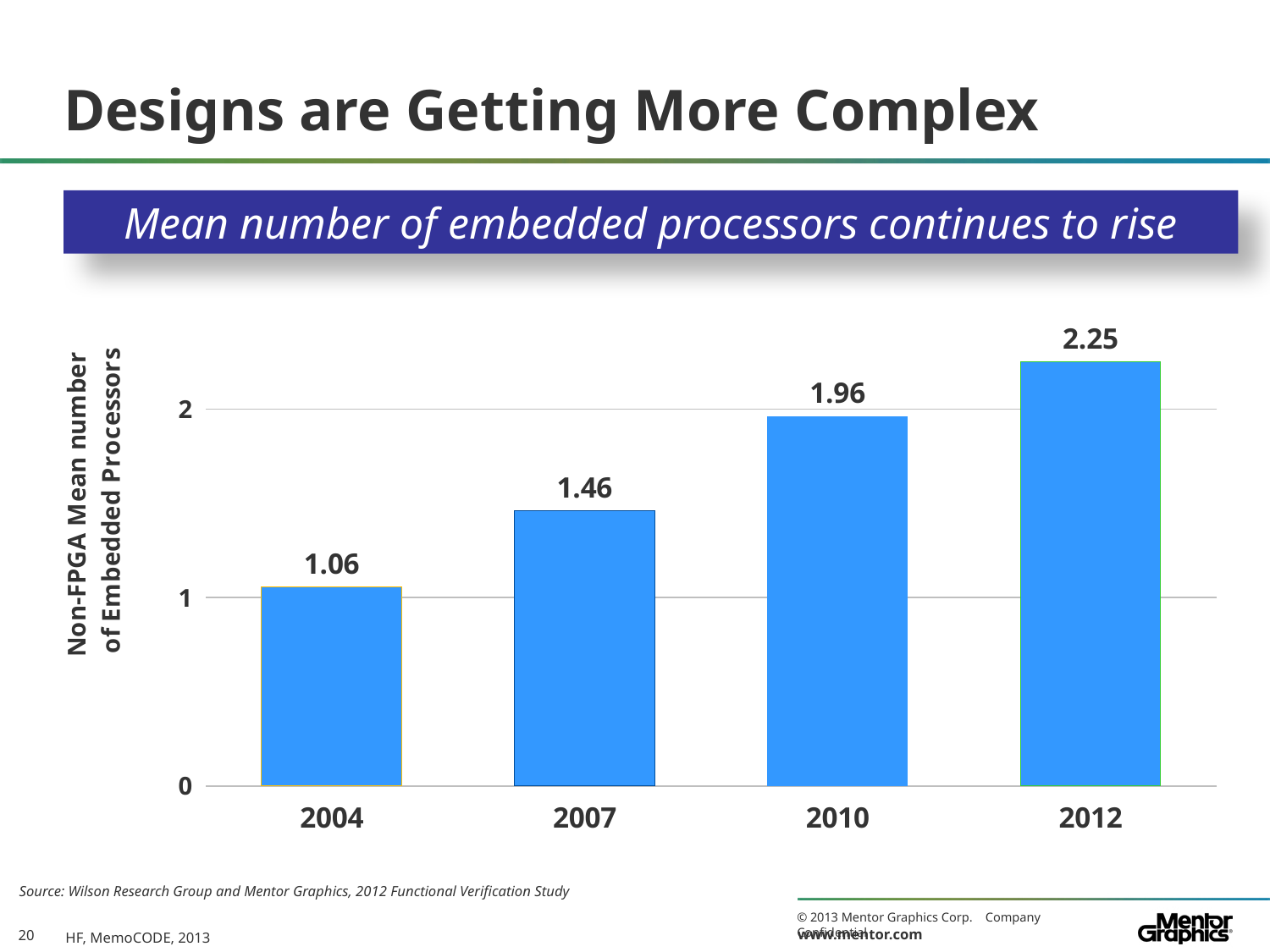
What is the non-FPGA mean number of embedded processors for 2012? 2.25 What is the non-FPGA mean number of embedded processors for 2007? 1.46 What is the difference between the 2010 and 2007 values? 0.50 What is the non-FPGA mean number of embedded processors for 2010? 1.96 Do the values rise or fall from 2004 to 2012? Rise What kind of chart is shown on the slide? Bar chart Which year has the lowest mean number of embedded processors? 2004 What is the non-FPGA mean number of embedded processors for 2004? 1.06 Which is larger, the value for 2007 or the value for 2010? 2010 What is the difference between the 2012 and 2004 values? 1.19 How many years are shown on the x axis? 4 Which year has the highest mean number of embedded processors? 2012